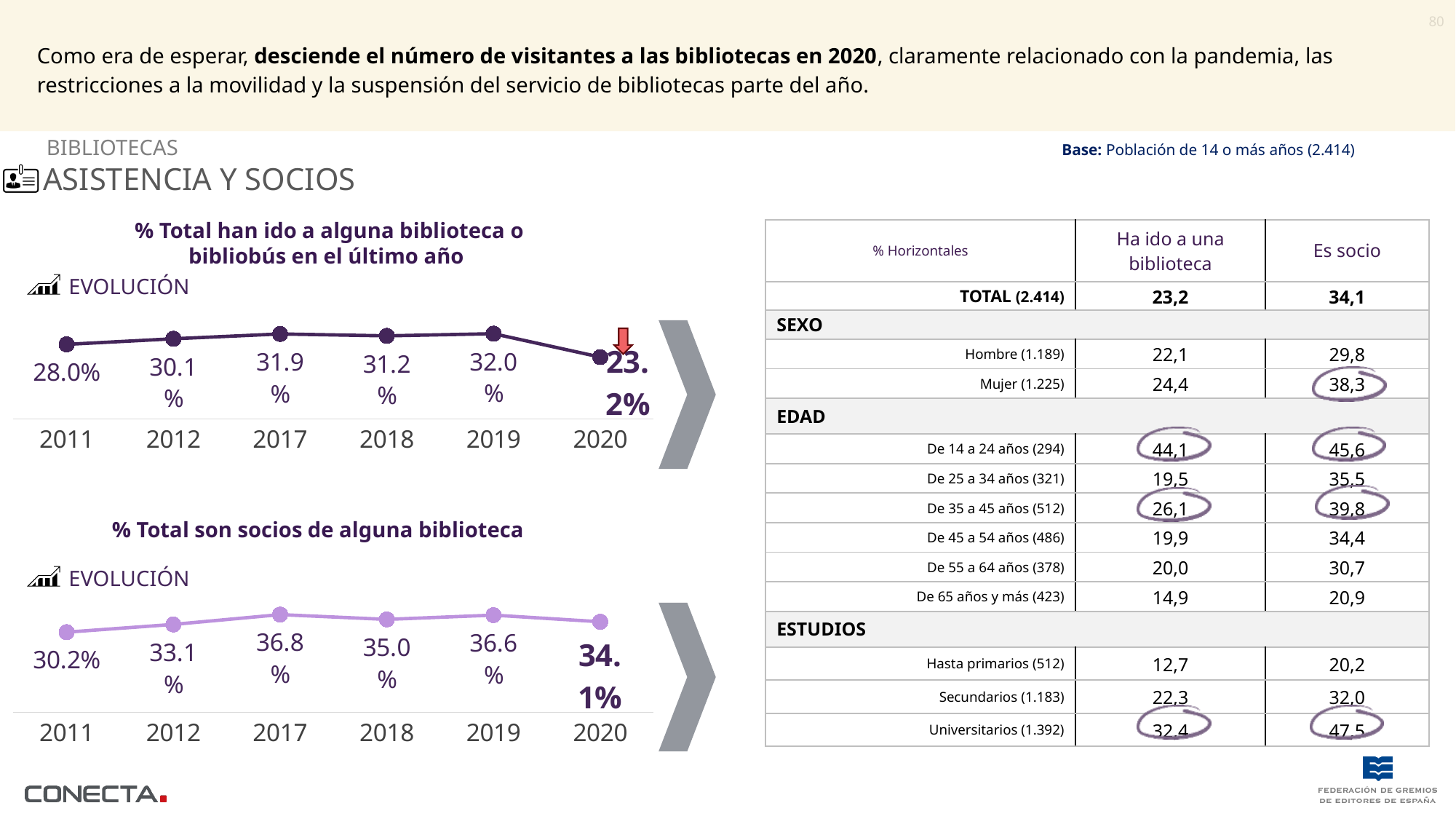
In the top chart '% Total han ido a alguna biblioteca o bibliobús en el último año', what is the difference between the 2019 and 2020 values? 8.8 percentage points In the bottom chart '% Total son socios de alguna biblioteca', which year has the lowest value? 2011 In the top chart '% Total han ido a alguna biblioteca o bibliobús en el último año', what is the value for 2011? 28.0% In the bottom chart '% Total son socios de alguna biblioteca', what is the difference between the 2012 and 2011 values? 2.9 percentage points In the bottom chart '% Total son socios de alguna biblioteca', what is the value for 2017? 36.8% What kind of chart is the bottom chart '% Total son socios de alguna biblioteca'? Line chart In the top chart '% Total han ido a alguna biblioteca o bibliobús en el último año', which year has the highest value? 2019 In the top chart '% Total han ido a alguna biblioteca o bibliobús en el último año', how many years are plotted? 6 In the bottom chart '% Total son socios de alguna biblioteca', which is larger, the value for 2018 or the value for 2019? 2019 In the bottom chart '% Total son socios de alguna biblioteca', what is the value for 2020? 34.1% In the top chart '% Total han ido a alguna biblioteca o bibliobús en el último año', which year has the lowest value? 2020 In the top chart '% Total han ido a alguna biblioteca o bibliobús en el último año', what is the value for 2020? 23.2%